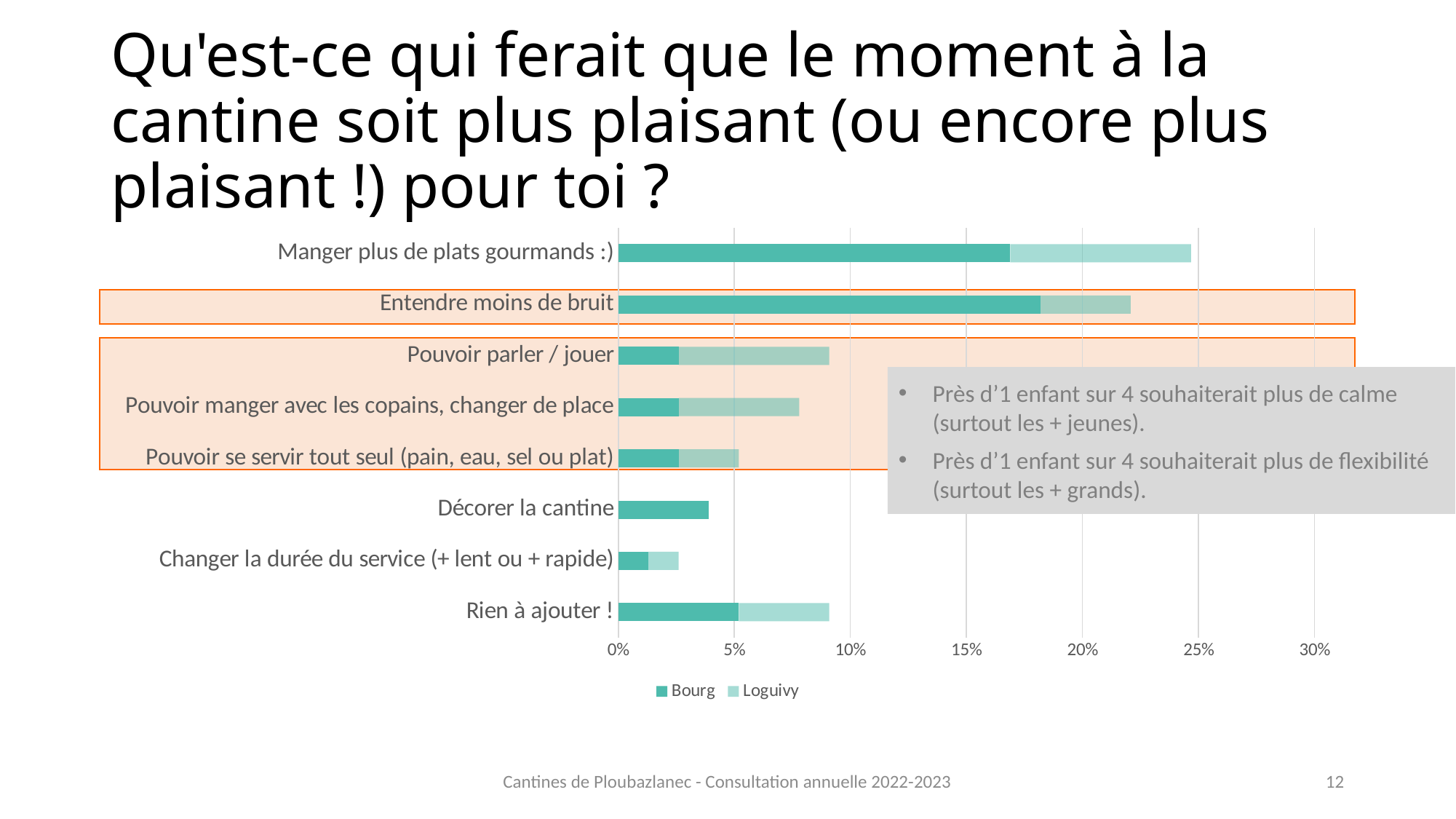
Which has the larger total bar: 'Pouvoir parler / jouer' or 'Pouvoir se servir tout seul (pain, eau, sel ou plat)'? Pouvoir parler / jouer Is the Bourg value for 'Entendre moins de bruit' greater or less than 15%? greater How many categories are plotted on the chart? 8 What are the two series named in the legend? Bourg and Loguivy Which category has the longest total bar? Manger plus de plats gourmands :) What kind of chart is shown on the slide? Stacked bar chart Which has the larger total bar: 'Décorer la cantine' or 'Changer la durée du service (+ lent ou + rapide)'? Décorer la cantine Is the value for 'Décorer la cantine' greater or less than 5%? less Is the total value for 'Rien à ajouter !' greater or less than 5%? greater How many series does the legend list? 2 Which category has the shortest total bar? Changer la durée du service (+ lent ou + rapide)